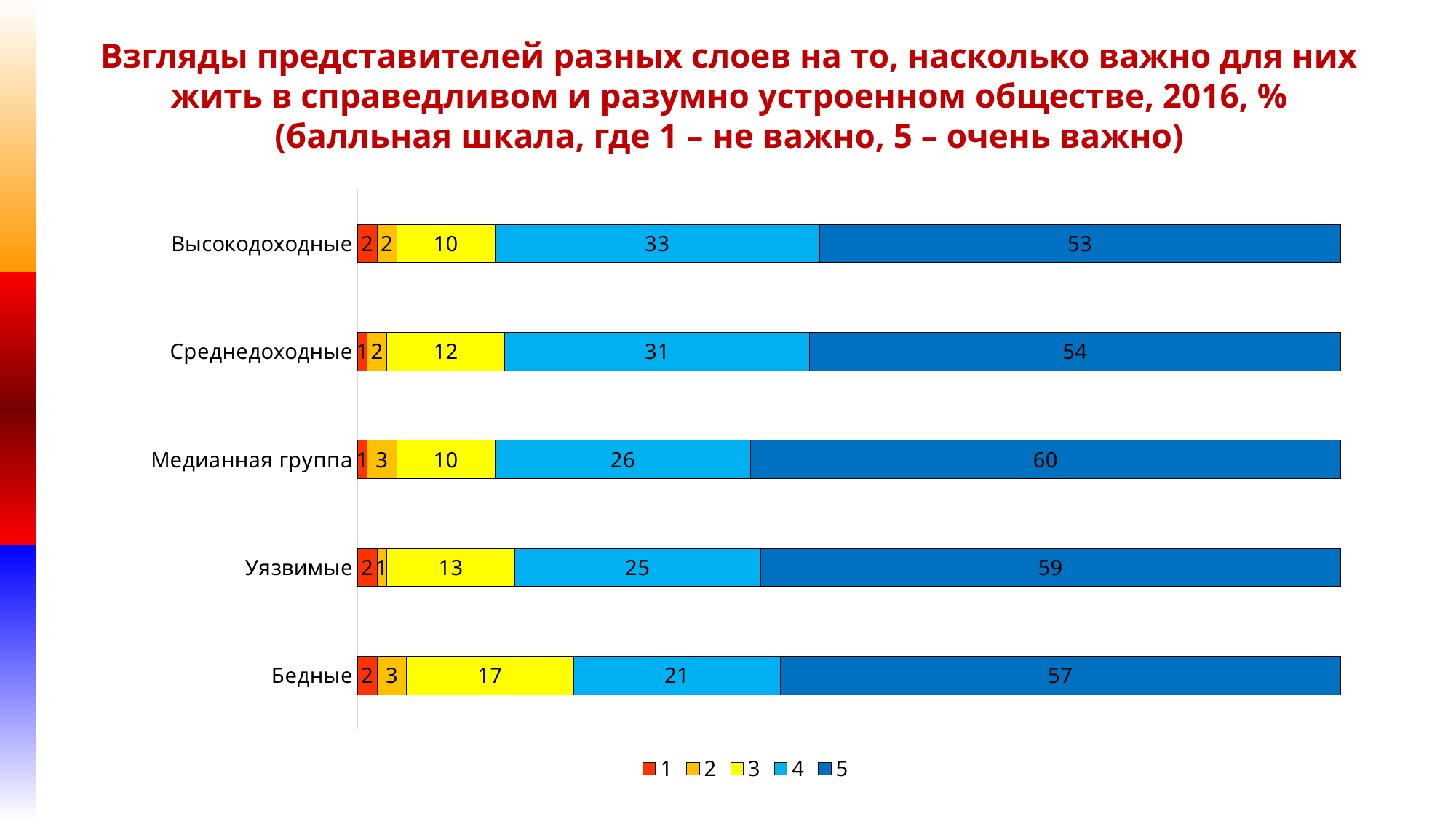
How many series does the legend list? 5 What is the total of the stacked bar for Бедные? 100 How many categories are shown on the chart? 5 Which legend entry is shown in yellow? 3 Which category has the highest value for score 5? Медианная группа What is the value for score 4 in the Высокодоходные category? 33 What is the value for score 5 in the Медианная группа category? 60 Which is larger: the score 3 value for Уязвимые or for Среднедоходные? Уязвимые Which category has the lowest value for score 4? Бедные What is the value for score 3 in the Бедные category? 17 What kind of chart is shown on the slide? Stacked bar chart What is the difference between the score 5 values for Медианная группа and Высокодоходные? 7